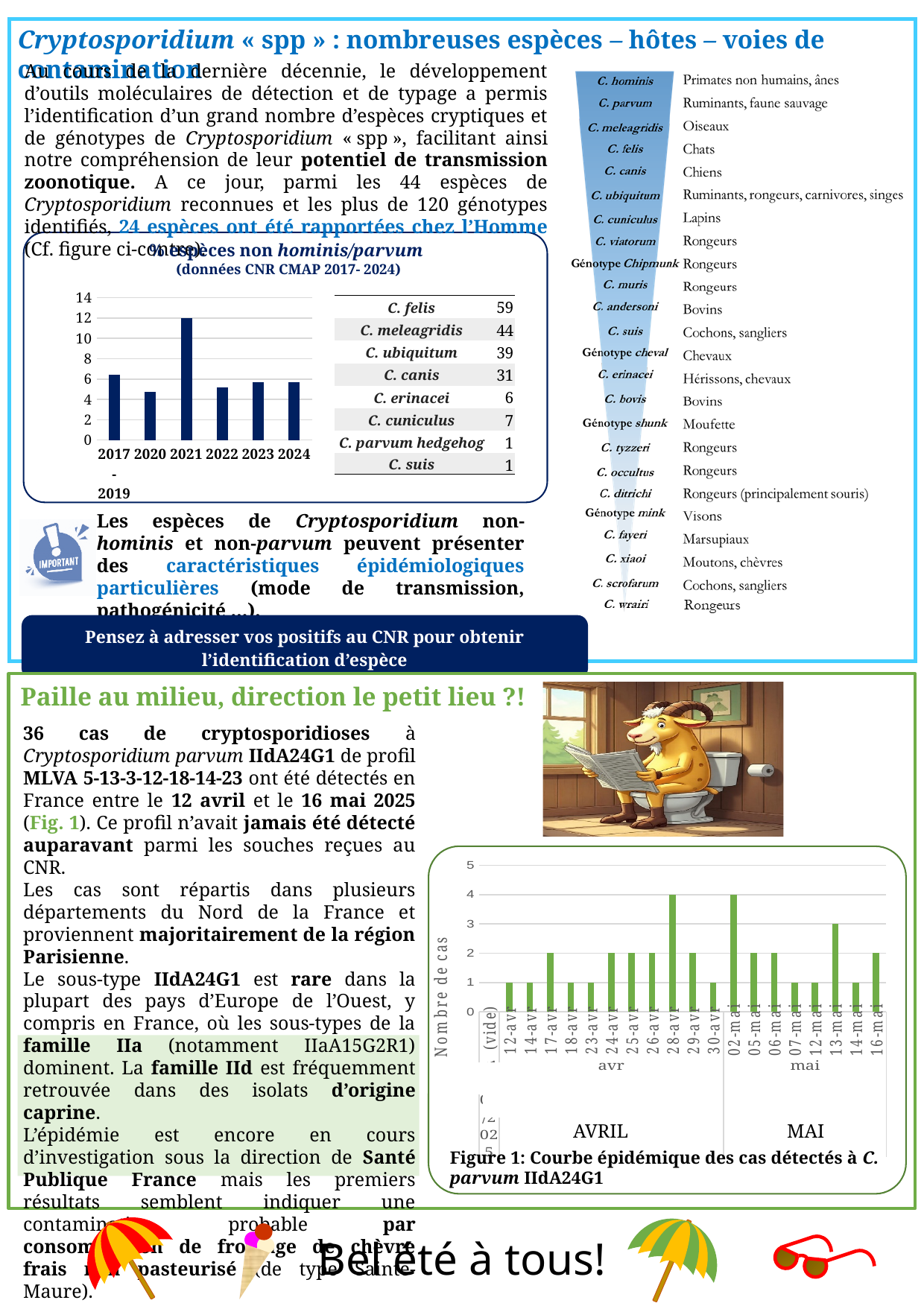
In Figure 1 (the epidemic curve), what is the label of the y axis? Nombre de cas In the chart titled '% espèces non hominis/parvum', is the value for 2020 greater or less than 6? less What kind of chart is the '% espèces non hominis/parvum' chart? bar chart In the chart titled '% espèces non hominis/parvum', which year has the highest bar? 2021 In Figure 1 (the epidemic curve), what is the number of cases on 28-avr? 4 In Figure 1 (the epidemic curve), what is the number of cases on 17-avr? 2 In Figure 1 (the epidemic curve), what is the difference between the number of cases on 02-mai and on 05-mai? 2 In Figure 1 (the epidemic curve), which is larger, the number of cases on 28-avr or on 29-avr? 28-avr In the chart titled '% espèces non hominis/parvum', is the value for 2021 greater or less than 10? greater In Figure 1 (the epidemic curve), what is the number of cases on 13-mai? 3 In the chart titled '% espèces non hominis/parvum', how many year categories are shown on the x axis? 6 In the chart titled '% espèces non hominis/parvum', which is larger, the value for 2021 or the value for 2022? 2021